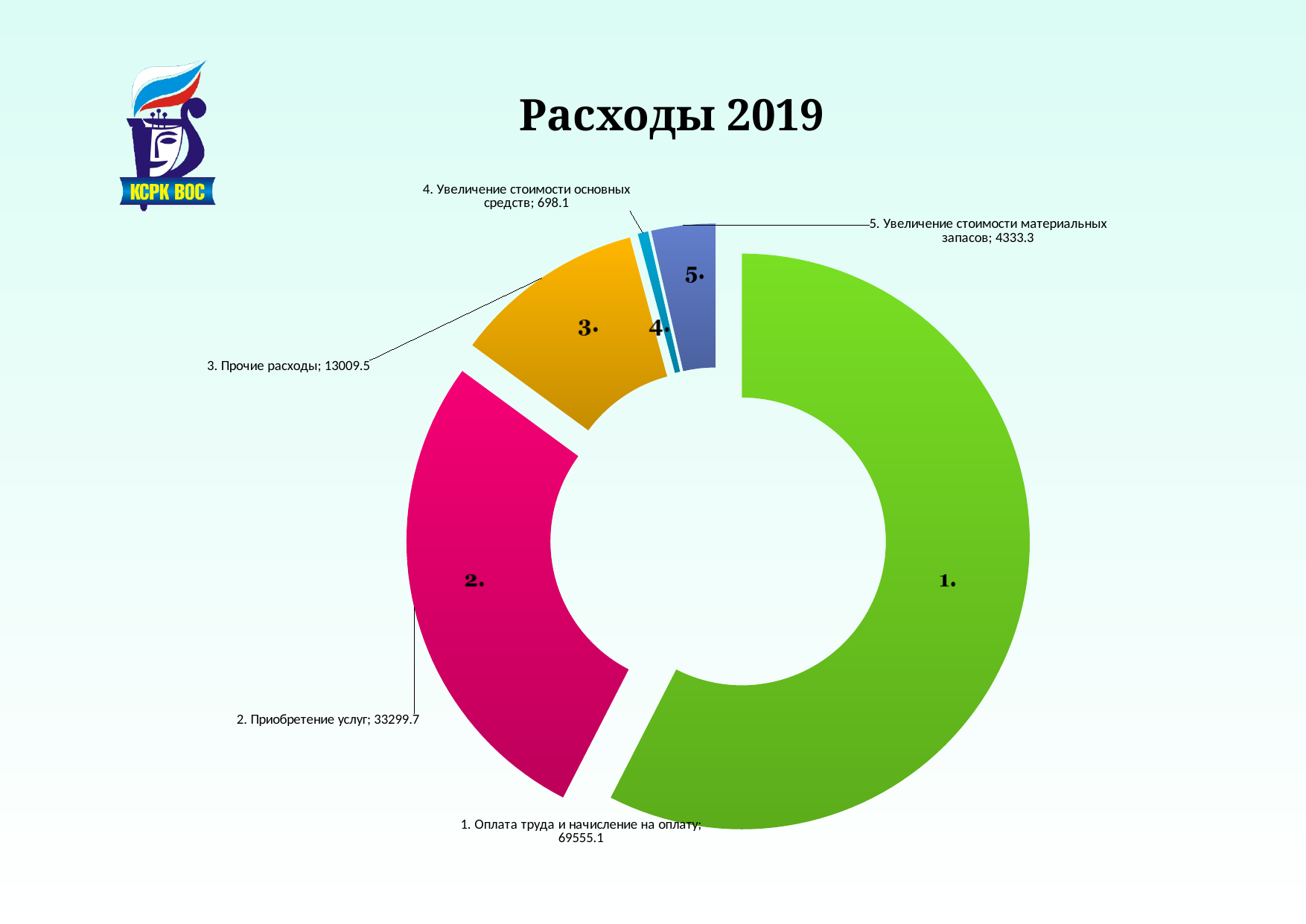
What is the difference between the values for "1. Оплата труда и начисление на оплату" and "2. Приобретение услуг"? 36255.4 What is the value for "5. Увеличение стоимости материальных запасов"? 4333.3 Which is larger: "3. Прочие расходы" or "5. Увеличение стоимости материальных запасов"? 3. Прочие расходы Which category has the smallest value? 4. Увеличение стоимости основных средств What is the value for "3. Прочие расходы"? 13009.5 What is the title of the slide/chart? Расходы 2019 What is the value for "4. Увеличение стоимости основных средств"? 698.1 How many categories (slices) does the chart show? 5 Which category has the largest value? 1. Оплата труда и начисление на оплату What is the value for "2. Приобретение услуг"? 33299.7 What is the value for "1. Оплата труда и начисление на оплату"? 69555.1 What kind of chart is shown on the slide? doughnut chart